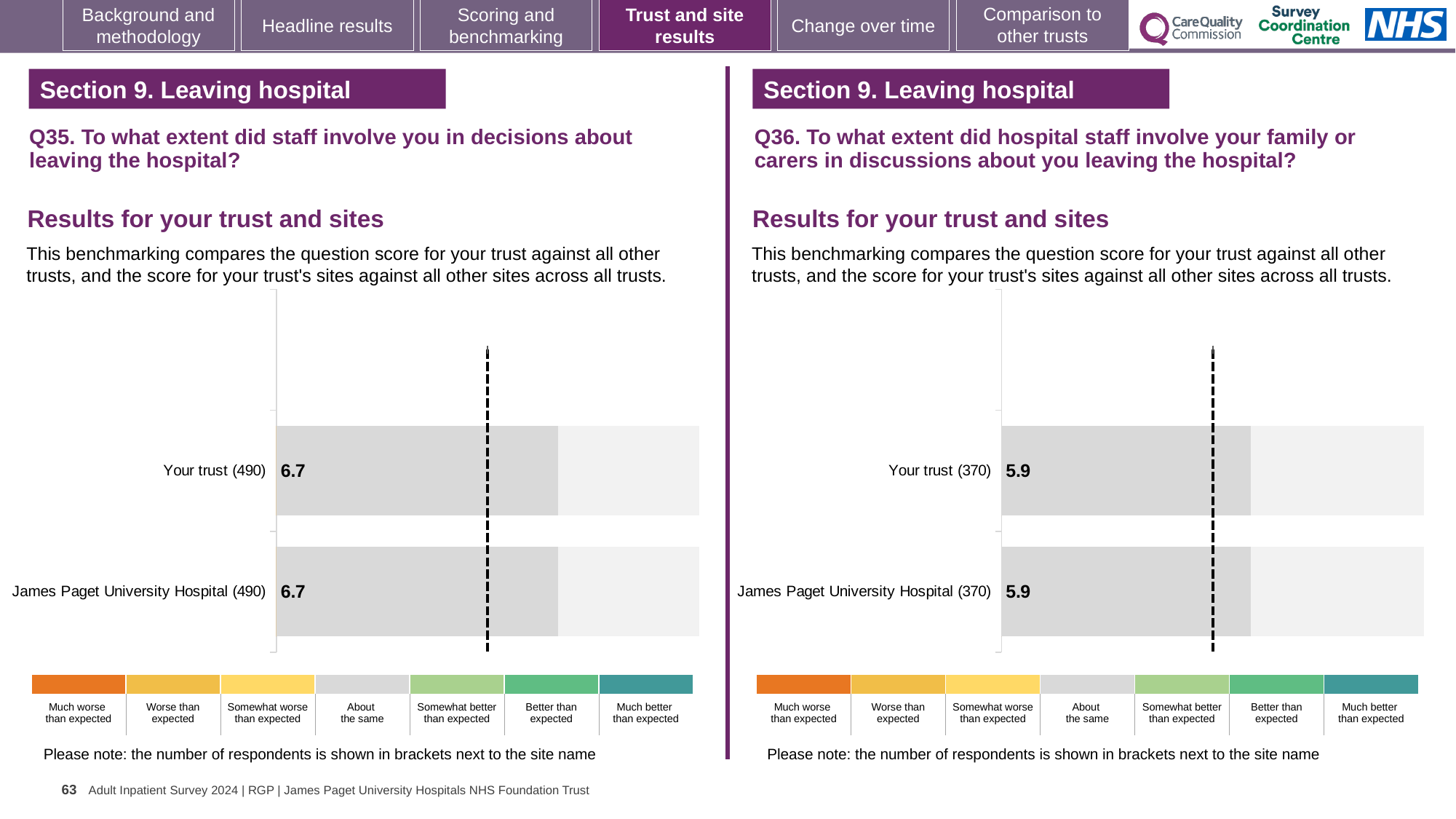
In the Q36 chart on the right, what is the score for James Paget University Hospital? 5.9 In the Q35 chart on the left, what is the score for James Paget University Hospital? 6.7 How many categories does the colour legend below the Q36 chart on the right list? 7 In the Q36 chart on the right, how many respondents are shown in brackets next to James Paget University Hospital? 370 In the Q35 chart on the left, what is the difference between the score for Your trust and the score for James Paget University Hospital? 0.0 How many bars are plotted in the Q36 chart on the right? 2 How many bars are plotted in the Q35 chart on the left? 2 In the Q36 chart on the right, what is the score for Your trust? 5.9 In the Q35 chart on the left, how many respondents are shown in brackets next to Your trust? 490 What kind of chart is the Q35 chart on the left? Bar chart In the Q36 chart on the right, what is the difference between the score for Your trust and the score for James Paget University Hospital? 0.0 In the Q35 chart on the left, what is the score for Your trust? 6.7